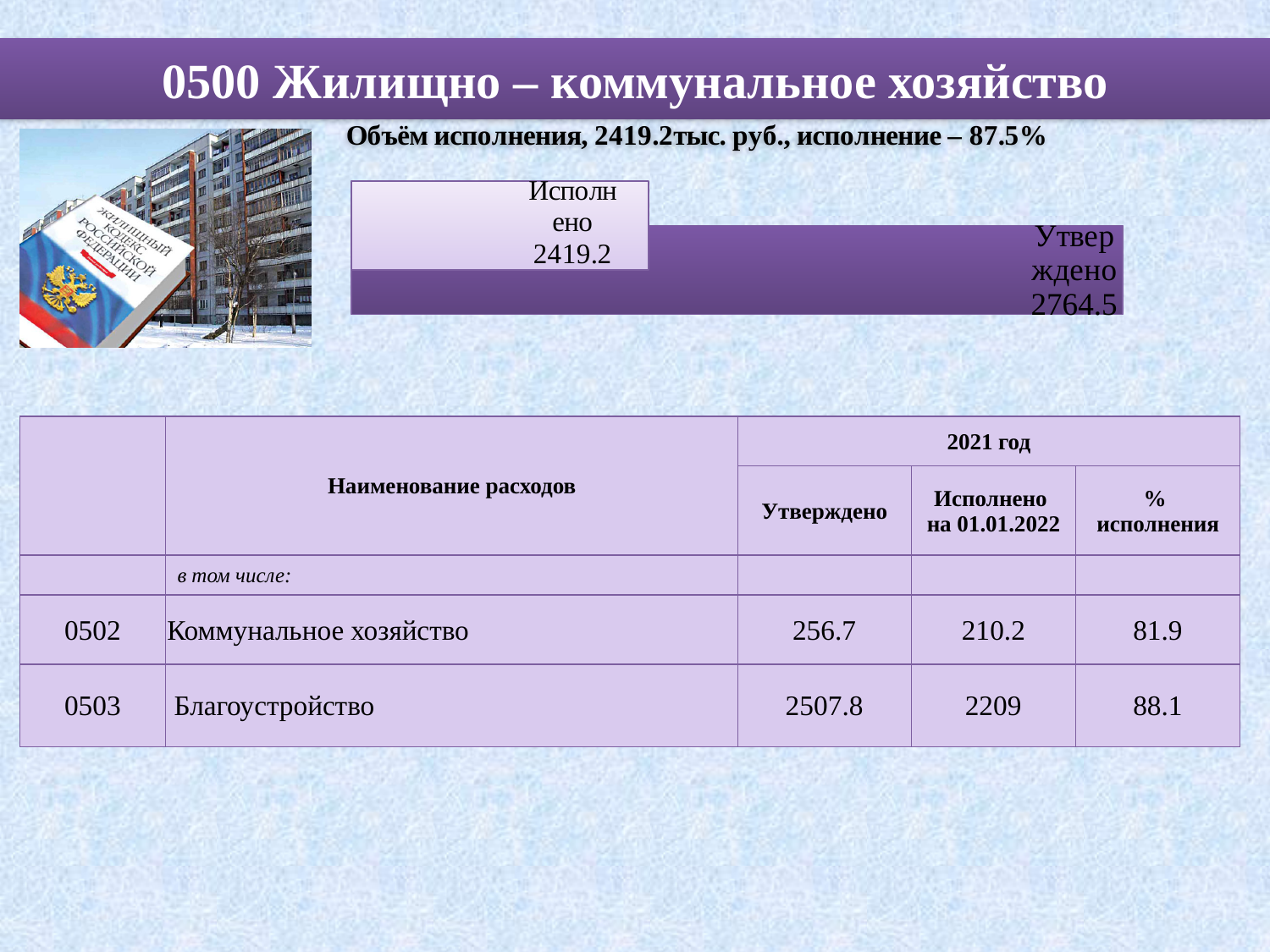
Is the value for Исполнено larger or smaller than the value for Утверждено? smaller What value is shown for the bar labelled Утверждено? 2764.5 What is the difference between the Утверждено value and the Исполнено value? 345.3 Are the bars in the chart drawn horizontally or vertically? horizontally Which bar has the lower value in the chart? Исполнено How many bars are plotted in the chart? 2 Which bar has the higher value, Исполнено or Утверждено? Утверждено What value is shown for the bar labelled Исполнено? 2419.2 Which bar is drawn in the darker purple colour? Утверждено What kind of chart is shown below the heading about Объём исполнения? bar chart